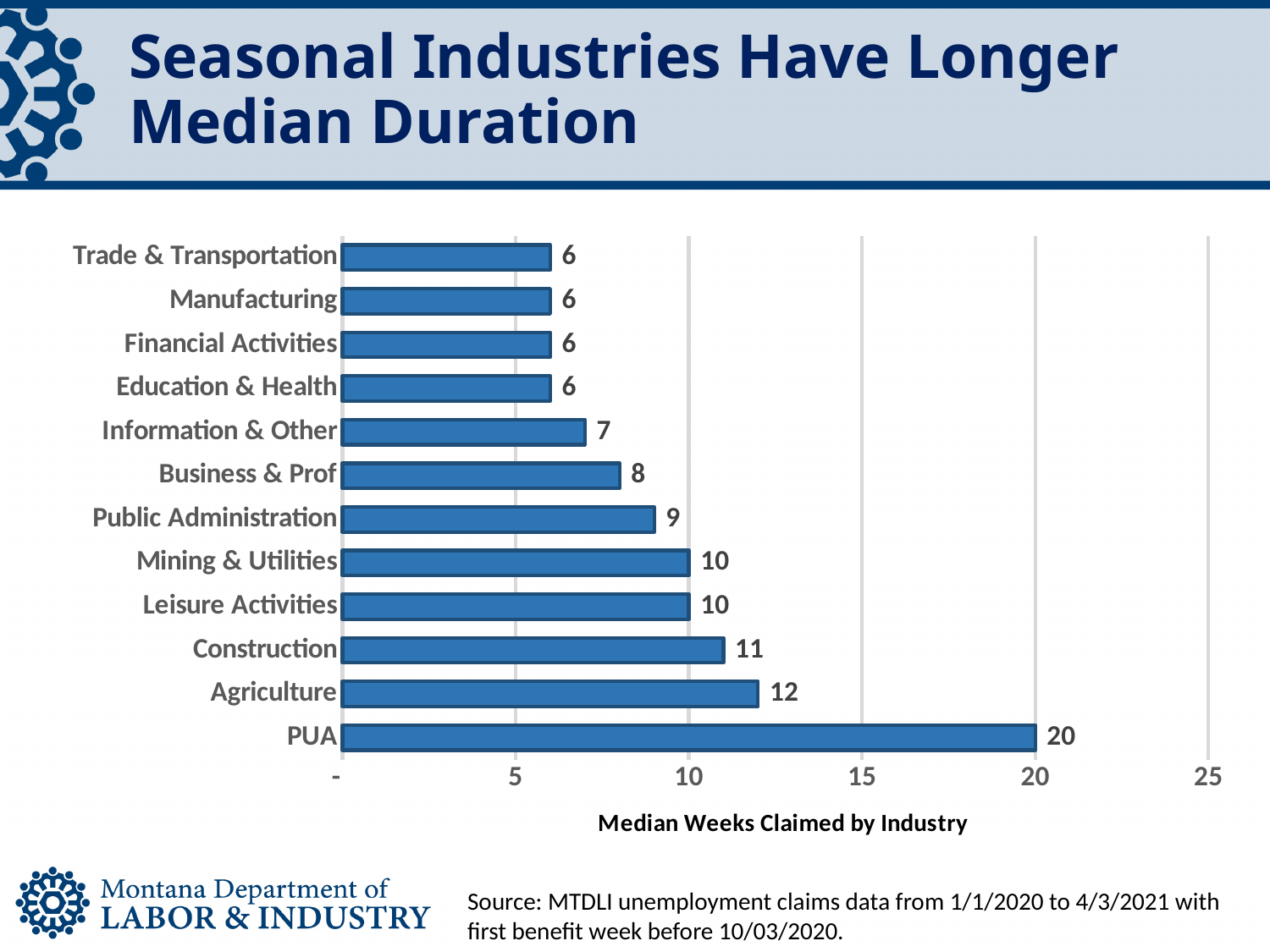
What is the difference in median weeks claimed between PUA and Construction? 9 Which category has the highest median weeks claimed? PUA What is the median weeks claimed for Agriculture? 12 What kind of chart is shown on the slide? Bar chart How many industry categories are shown in the chart? 12 Is the value for Agriculture greater or less than 10? greater Which has a higher median weeks claimed, Construction or Information & Other? Construction What is the difference in median weeks claimed between Agriculture and Business & Prof? 4 What is the x-axis title of the chart? Median Weeks Claimed by Industry How many categories have a median weeks claimed value of 6? 4 What is the median weeks claimed for PUA? 20 What is the median weeks claimed for Public Administration? 9